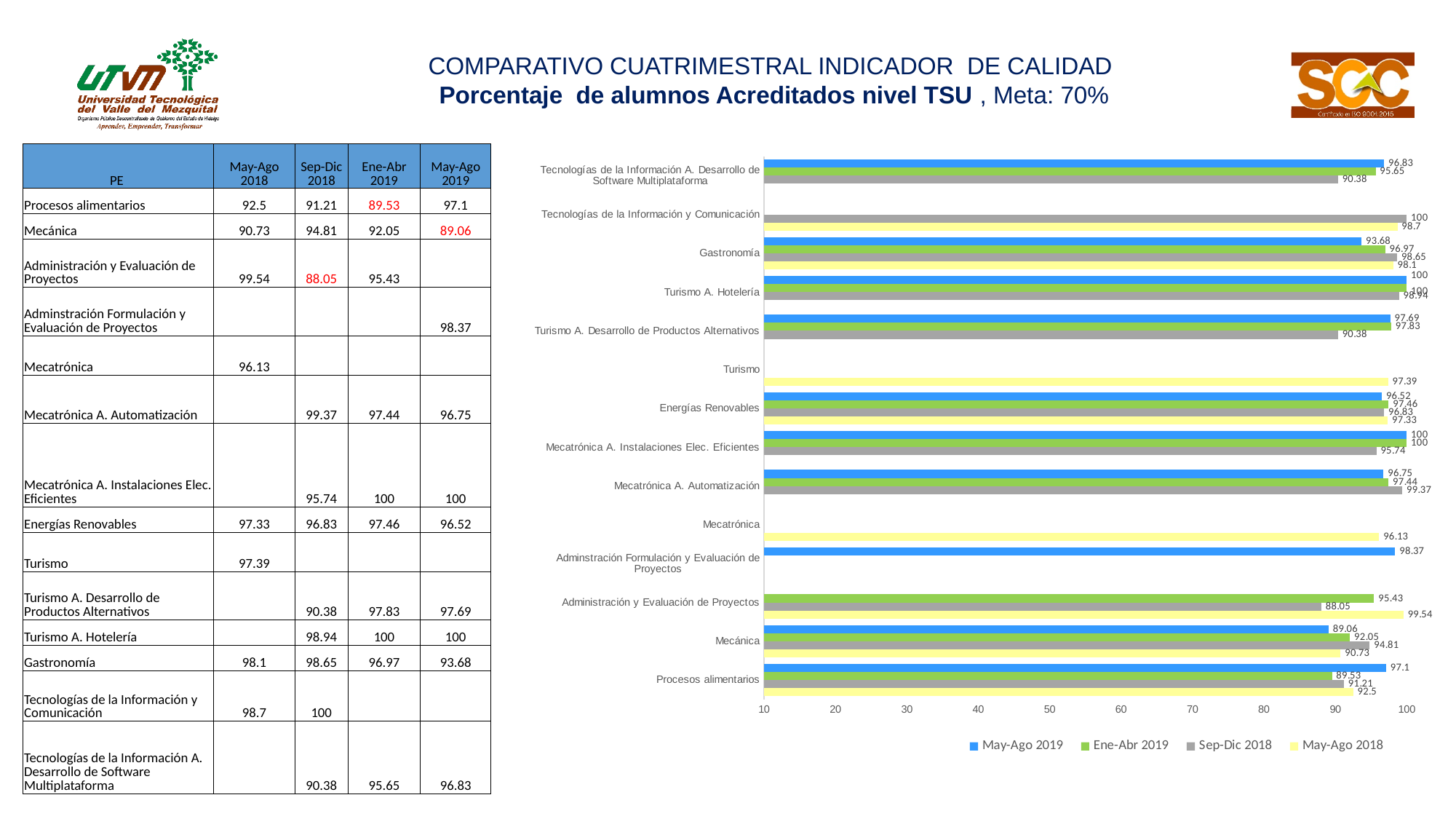
What is the May-Ago 2019 value for Procesos alimentarios? 97.1 Which series has the lowest value for Mecánica? May-Ago 2019 How many categories (programs) are shown on the chart's vertical axis? 14 What kind of chart is shown on the slide? bar chart Is the Sep-Dic 2018 value for Turismo A. Desarrollo de Productos Alternativos greater or less than 80? greater What is the Sep-Dic 2018 value for Administración y Evaluación de Proyectos? 88.05 Which series has the highest value for Gastronomía? Sep-Dic 2018 Which colour represents the Sep-Dic 2018 series in the chart? gray What is the difference between the May-Ago 2018 and Sep-Dic 2018 values for Administración y Evaluación de Proyectos? 11.49 What is the May-Ago 2018 value for Mecatrónica? 96.13 How many series does the chart legend list? 4 For Procesos alimentarios, which is larger: the May-Ago 2019 value or the Ene-Abr 2019 value? May-Ago 2019